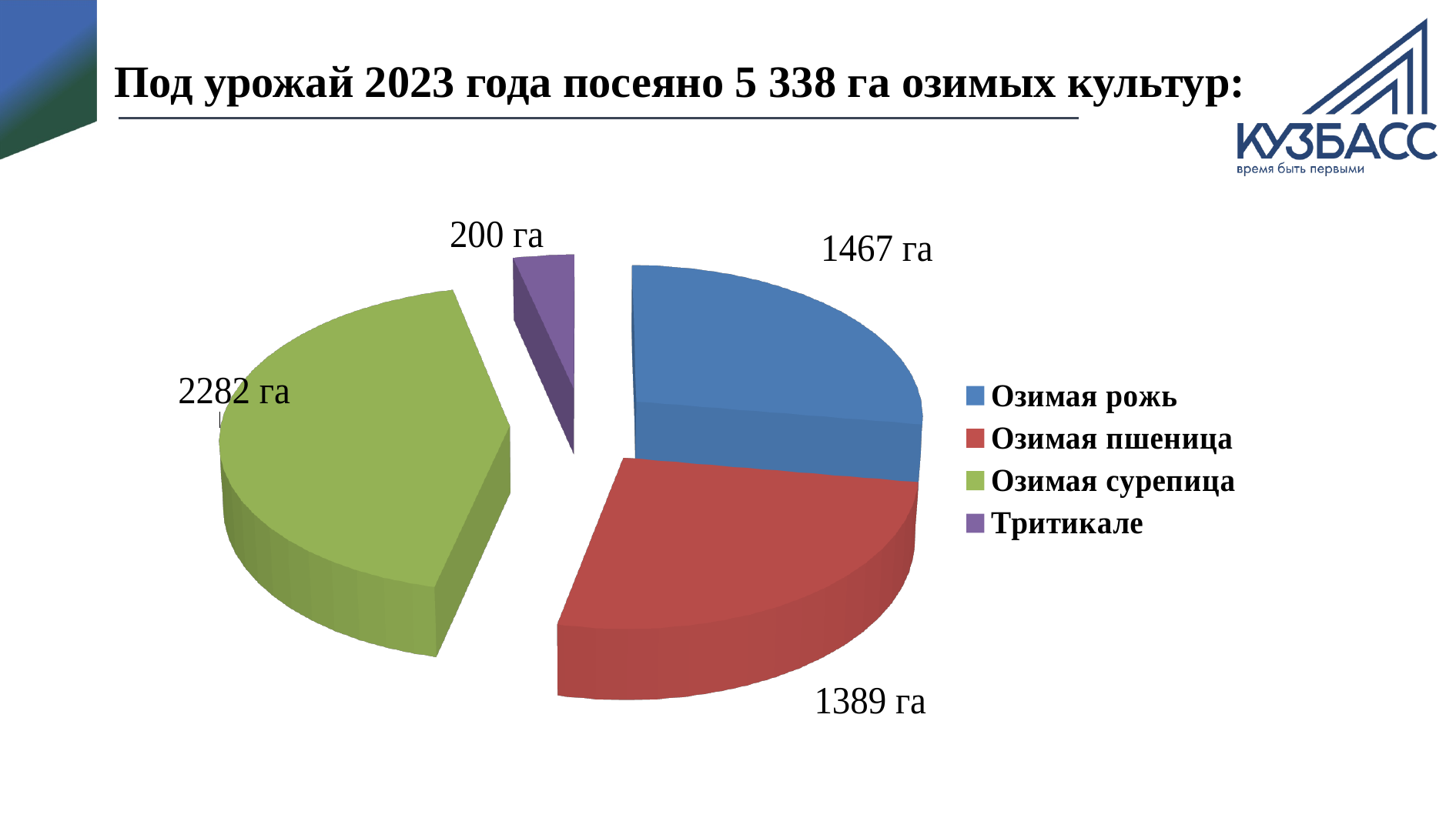
What colour is the slice for Тритикале? purple What is the value for Озимая сурепица? 2282 га What is the difference between the areas of Озимая сурепица and Озимая пшеница? 893 га What is the value for Озимая пшеница? 1389 га How many slices does the pie chart have? 4 Which crop has the largest area? Озимая сурепица What kind of chart is shown on the slide? pie chart Which crop has the smallest area? Тритикале How many entries does the legend list? 4 What is the value for Тритикале? 200 га What is the value for Озимая рожь? 1467 га Which is larger, the area of Озимая рожь or Озимая пшеница? Озимая рожь